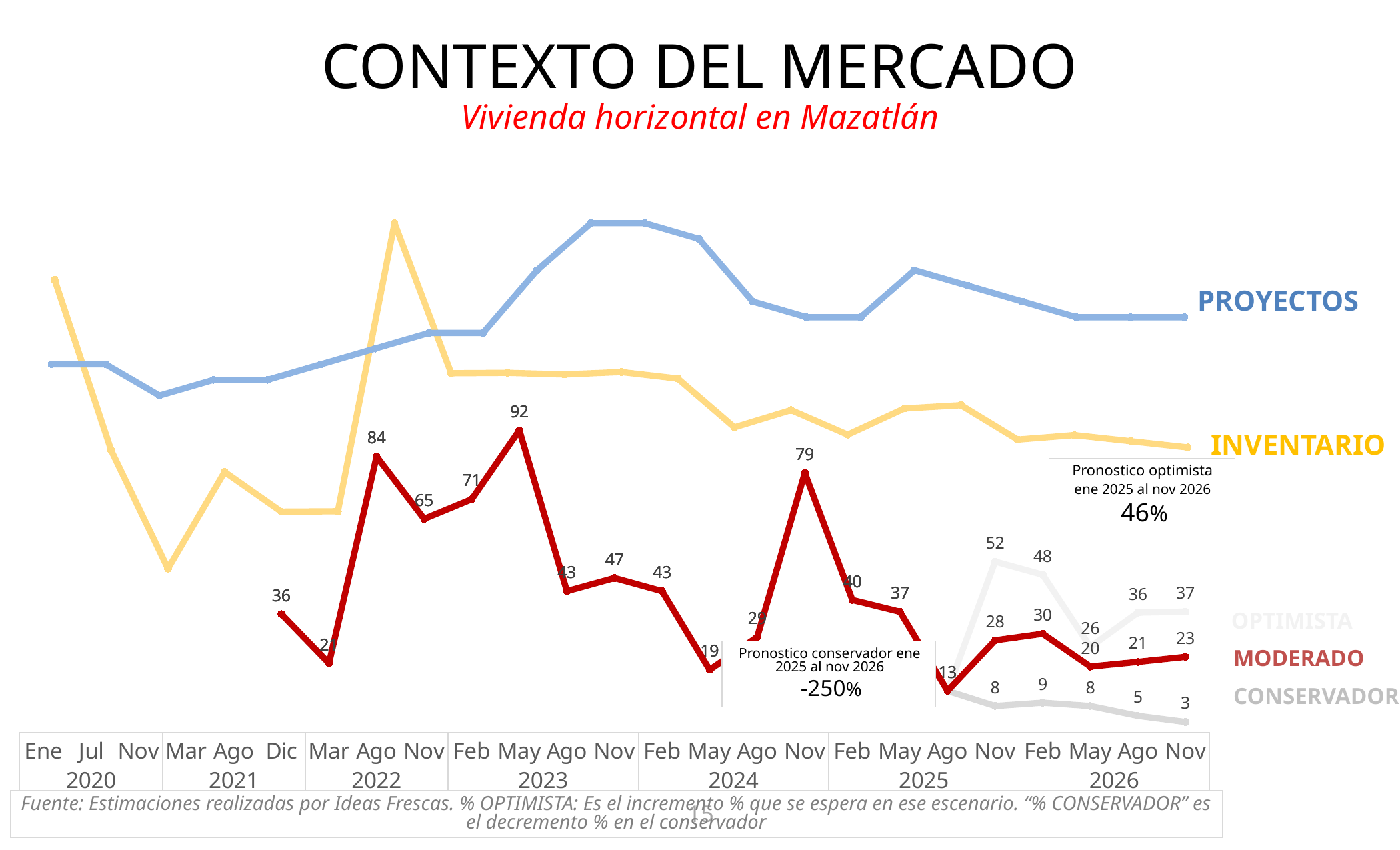
What percentage is given for the 'Pronostico optimista ene 2025 al nov 2026'? 46% How many series are labelled on the chart? 5 What is the value of the MODERADO line at Ago 2022? 84 Which is larger at Feb 2026: the OPTIMISTA value or the MODERADO value? OPTIMISTA What type of chart is shown on the slide? Line chart What is the lowest labelled value on the CONSERVADOR line? 3 What is the difference between the OPTIMISTA value (37) and the MODERADO value (23) at Nov 2026? 14 What is the highest labelled value on the MODERADO line? 92 What is the value of the CONSERVADOR line at Nov 2026? 3 What is the value of the OPTIMISTA line at Nov 2025? 52 What is the subtitle of the chart shown in red under the main title? Vivienda horizontal en Mazatlán What is the value of the MODERADO line at Nov 2024? 79